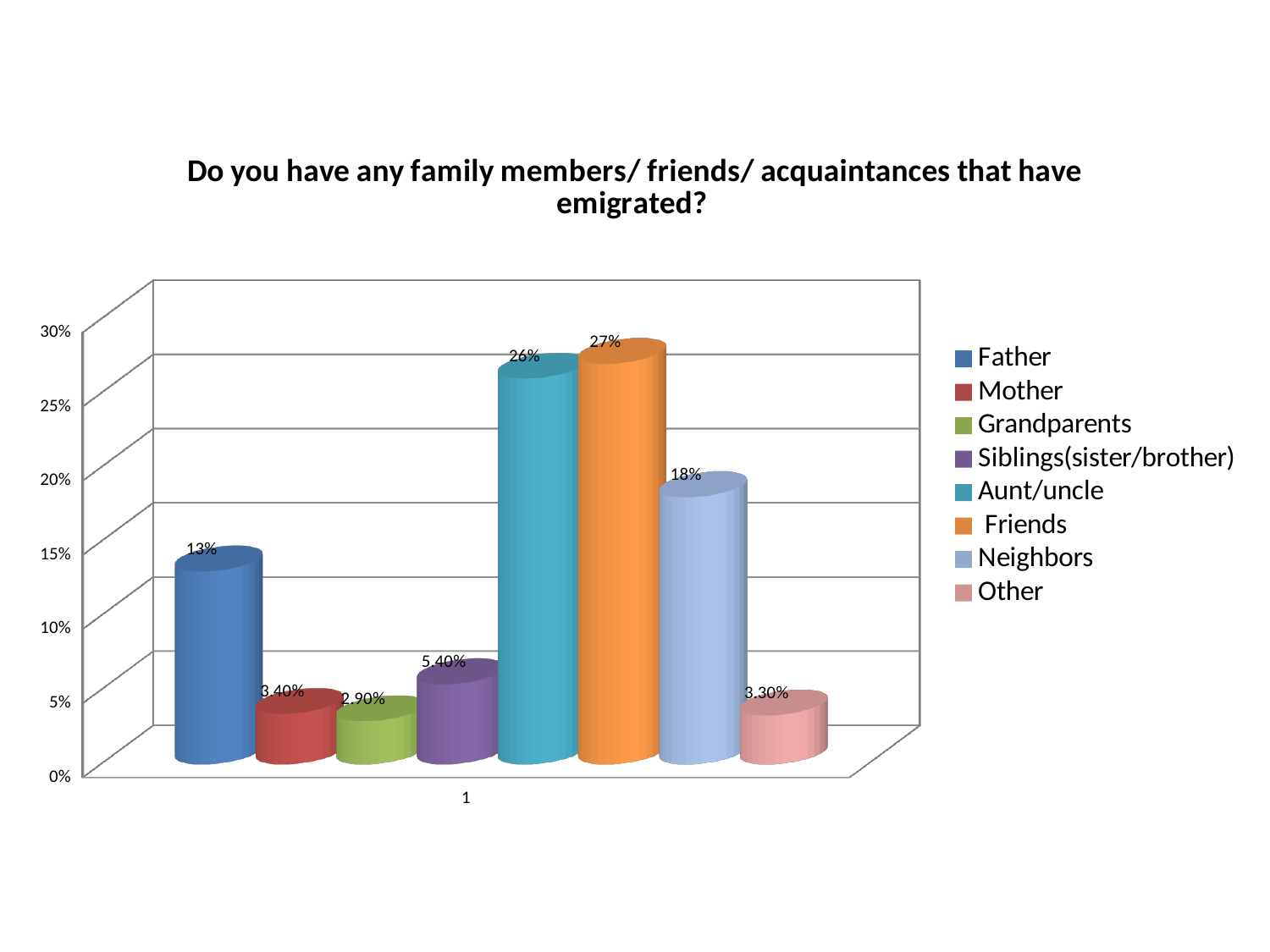
Which series has the lowest value? Grandparents Which is larger, the value for Mother or the value for Other? Mother What is the value for Siblings(sister/brother)? 5.40% What is the value for Father? 13% What is the value for Aunt/uncle? 26% Which series has the highest value? Friends Is the value for Neighbors greater or less than 15%? greater What kind of chart is shown on the slide? bar chart How many series does the legend list? 8 What is the value for Neighbors? 18% What is the title of the chart? Do you have any family members/ friends/ acquaintances that have emigrated? What is the difference between the values for Friends and Neighbors? 9%